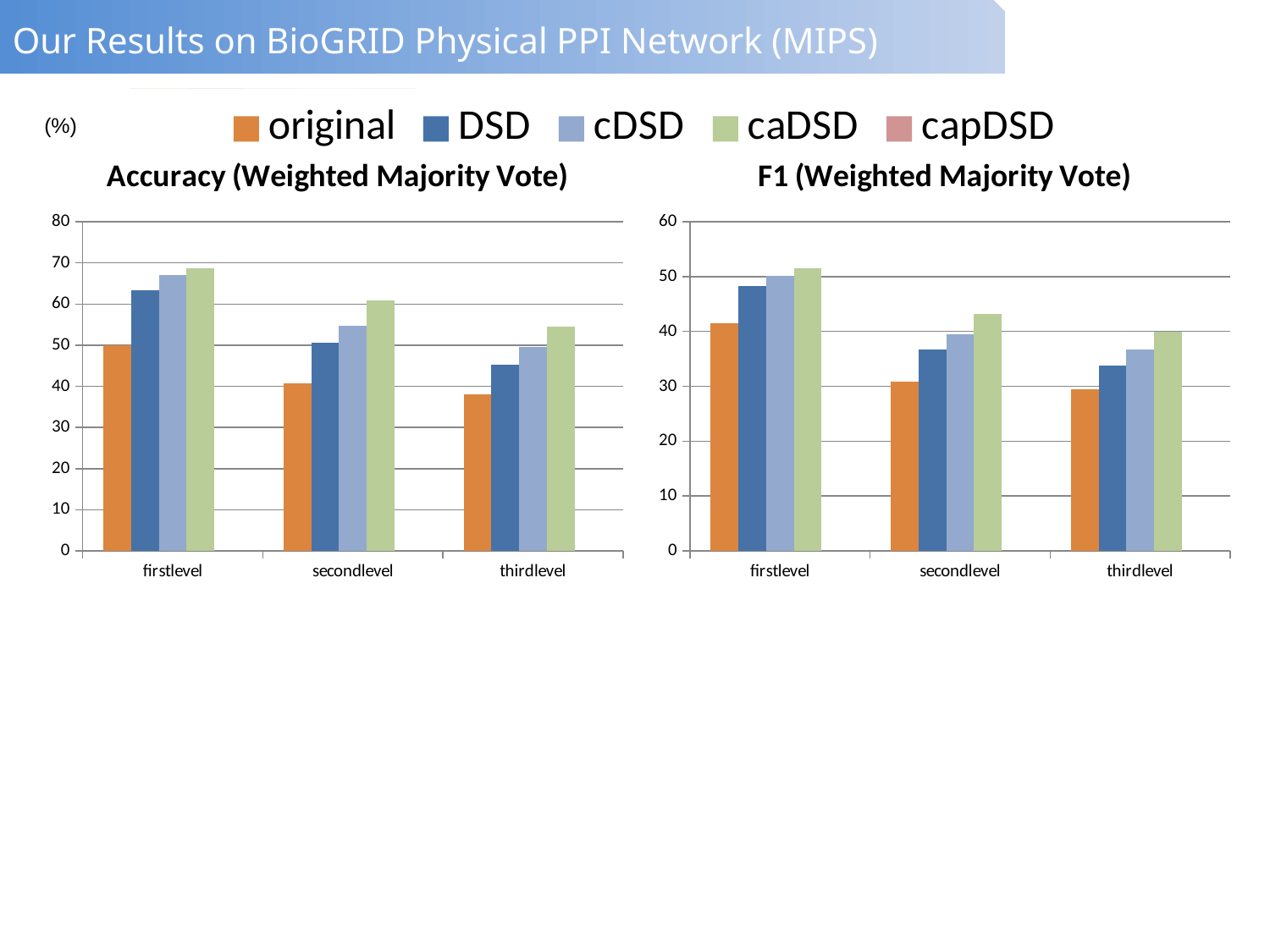
In the Accuracy (Weighted Majority Vote) chart, which series has the highest bar at firstlevel? caDSD In the Accuracy (Weighted Majority Vote) chart, is the value for DSD at firstlevel greater or less than 60? greater In the Accuracy (Weighted Majority Vote) chart, which is larger at firstlevel: original or DSD? DSD What colour represents the caDSD series in the legend? green In the F1 (Weighted Majority Vote) chart, which series has the lowest bar at thirdlevel? original In the Accuracy (Weighted Majority Vote) chart, is the value for original at thirdlevel greater or less than 40? less In the F1 (Weighted Majority Vote) chart, is the value for DSD at firstlevel greater or less than 50? less How many series does the legend list? 5 How many categories are shown on the x axis of the F1 (Weighted Majority Vote) chart? 3 What kind of chart is the Accuracy (Weighted Majority Vote) chart? bar chart In the F1 (Weighted Majority Vote) chart, do the values for the original series rise or fall from firstlevel to thirdlevel? fall